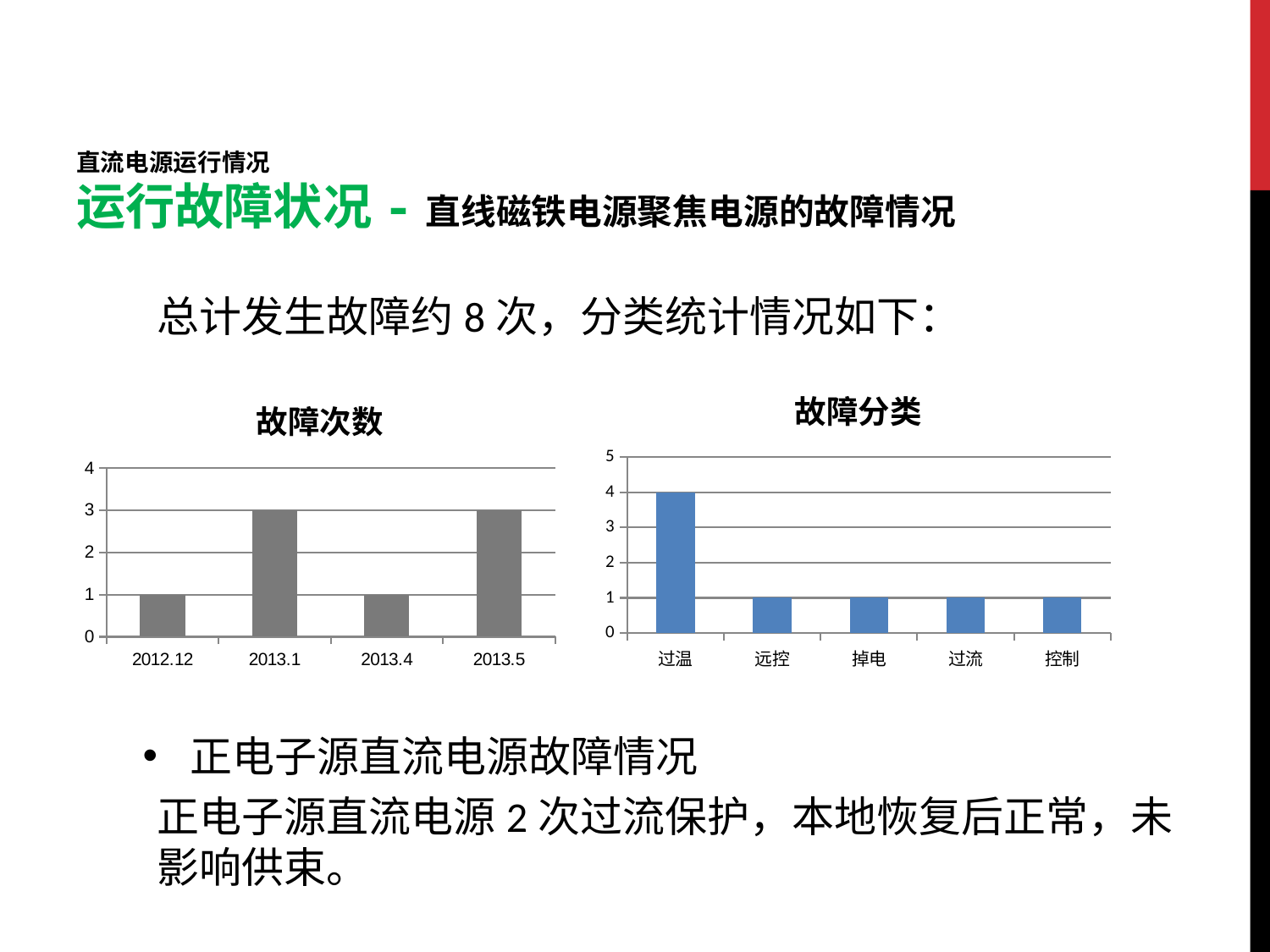
What kind of chart is the 故障次数 chart? bar chart In the 故障分类 chart, what is the value for 远控? 1 In the 故障分类 chart, how many categories are shown on the x axis? 5 In the 故障次数 chart, how many categories are shown on the x axis? 4 In the 故障次数 chart, what is the value for 2012.12? 1 In the 故障分类 chart, what is the difference between the values for 过温 and 掉电? 3 In the 故障次数 chart, what is the difference between the values for 2013.5 and 2013.4? 2 In the 故障次数 chart, what is the value for 2013.1? 3 What is the title of the chart on the right side of the slide? 故障分类 In the 故障分类 chart, which category has the highest value? 过温 In the 故障次数 chart, which is larger, the value for 2013.1 or the value for 2013.4? 2013.1 In the 故障分类 chart, what is the value for 过温? 4